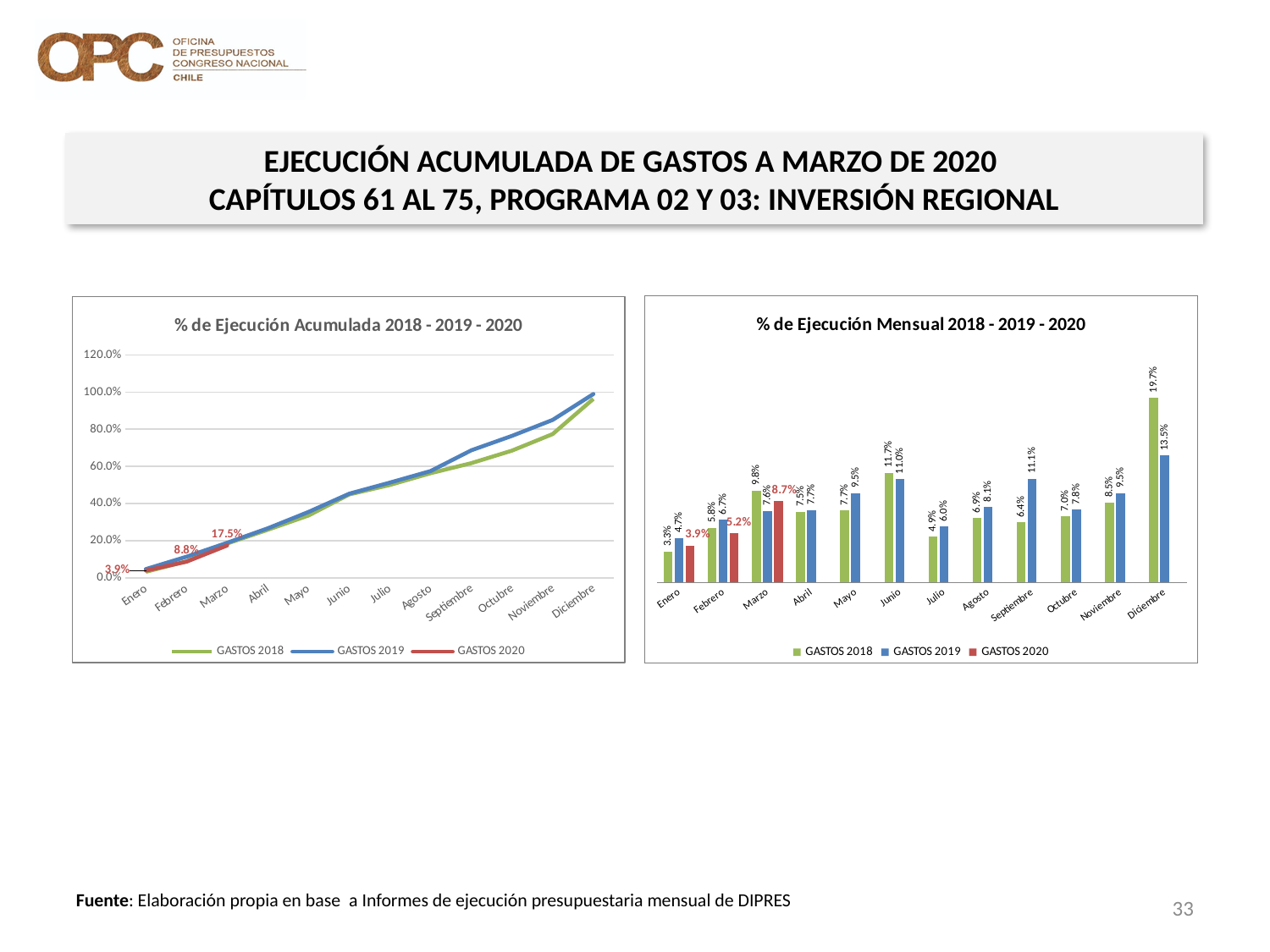
In the chart '% de Ejecución Mensual 2018 - 2019 - 2020', how many series does the legend list? 3 In the chart '% de Ejecución Mensual 2018 - 2019 - 2020', which month has the lowest value for GASTOS 2018? Enero In the chart '% de Ejecución Acumulada 2018 - 2019 - 2020', do the values for GASTOS 2018 rise or fall from Enero to Diciembre? Rise In the chart '% de Ejecución Mensual 2018 - 2019 - 2020', which is larger in Junio: GASTOS 2018 or GASTOS 2019? GASTOS 2018 In the chart '% de Ejecución Acumulada 2018 - 2019 - 2020', is the value for GASTOS 2019 in Noviembre greater or less than 80.0%? greater In the chart '% de Ejecución Acumulada 2018 - 2019 - 2020', what kind of chart is shown? Line chart In the chart '% de Ejecución Mensual 2018 - 2019 - 2020', which month has the highest value for GASTOS 2018? Diciembre In the chart '% de Ejecución Mensual 2018 - 2019 - 2020', what is the value for GASTOS 2019 in Diciembre? 13.5% In the chart '% de Ejecución Acumulada 2018 - 2019 - 2020', what is the value for GASTOS 2020 in Febrero? 8.8% In the chart '% de Ejecución Mensual 2018 - 2019 - 2020', what is the difference between GASTOS 2018 and GASTOS 2019 in Septiembre? 4.7% In the chart '% de Ejecución Acumulada 2018 - 2019 - 2020', what is the value for GASTOS 2020 in Marzo? 17.5% In the chart '% de Ejecución Mensual 2018 - 2019 - 2020', what is the value for GASTOS 2020 in Marzo? 8.7%